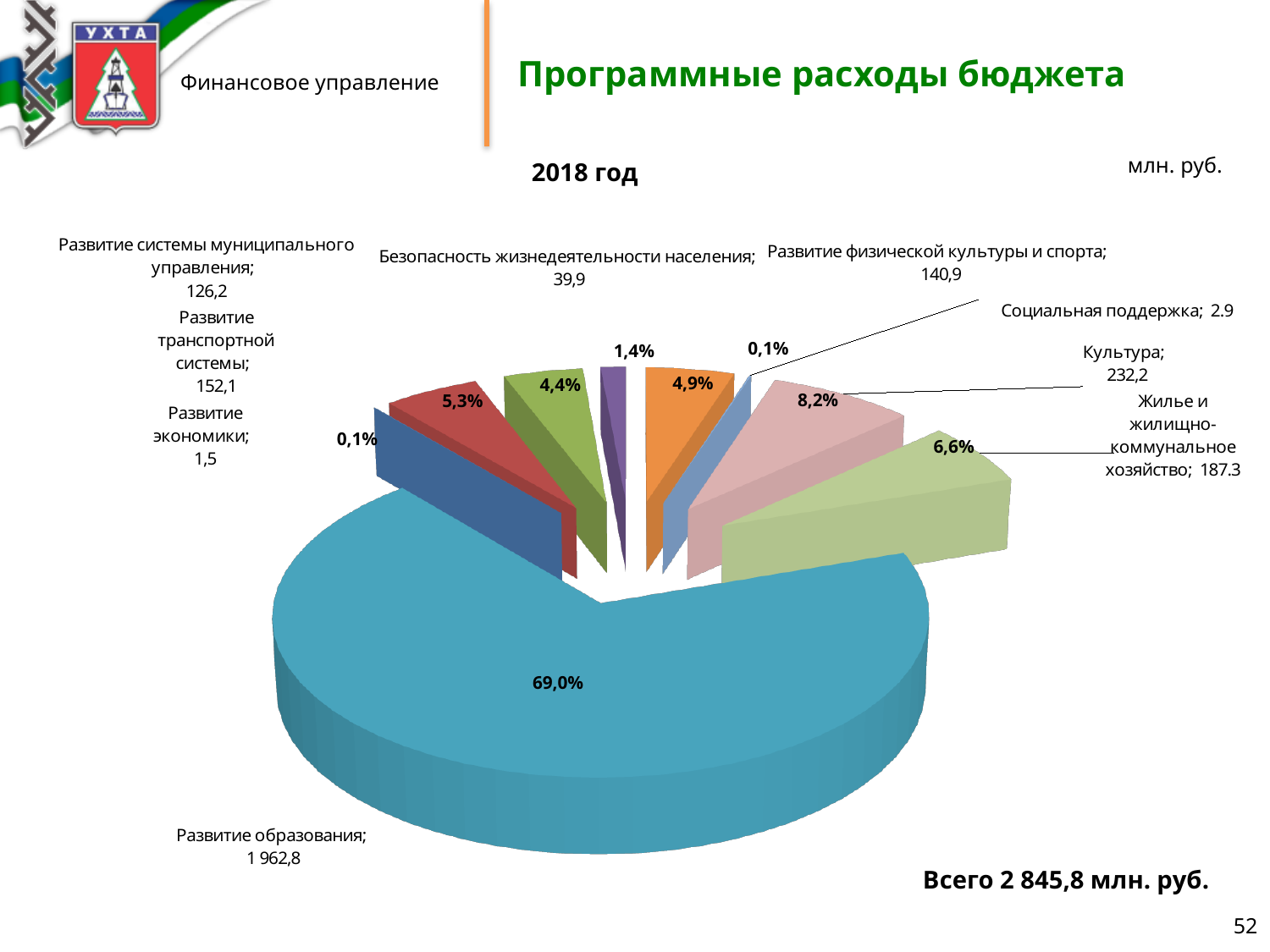
Which category has the smallest value? Развитие экономики What is the difference between Развитие транспортной системы and Развитие системы муниципального управления? 25,9 What is the value for Культура? 232,2 How many categories does the pie chart show? 9 Which category has the largest value? Развитие образования What kind of chart is shown on the slide? Pie chart What is the value for Развитие транспортной системы? 152,1 What share of the pie does Культура take? 8,2% What share of the pie does Развитие образования take? 69,0% What total is stated for the programme expenditures on the slide? 2 845,8 млн. руб. What is the value for Развитие образования? 1 962,8 Which is larger, Культура or Жилье и жилищно-коммунальное хозяйство? Культура